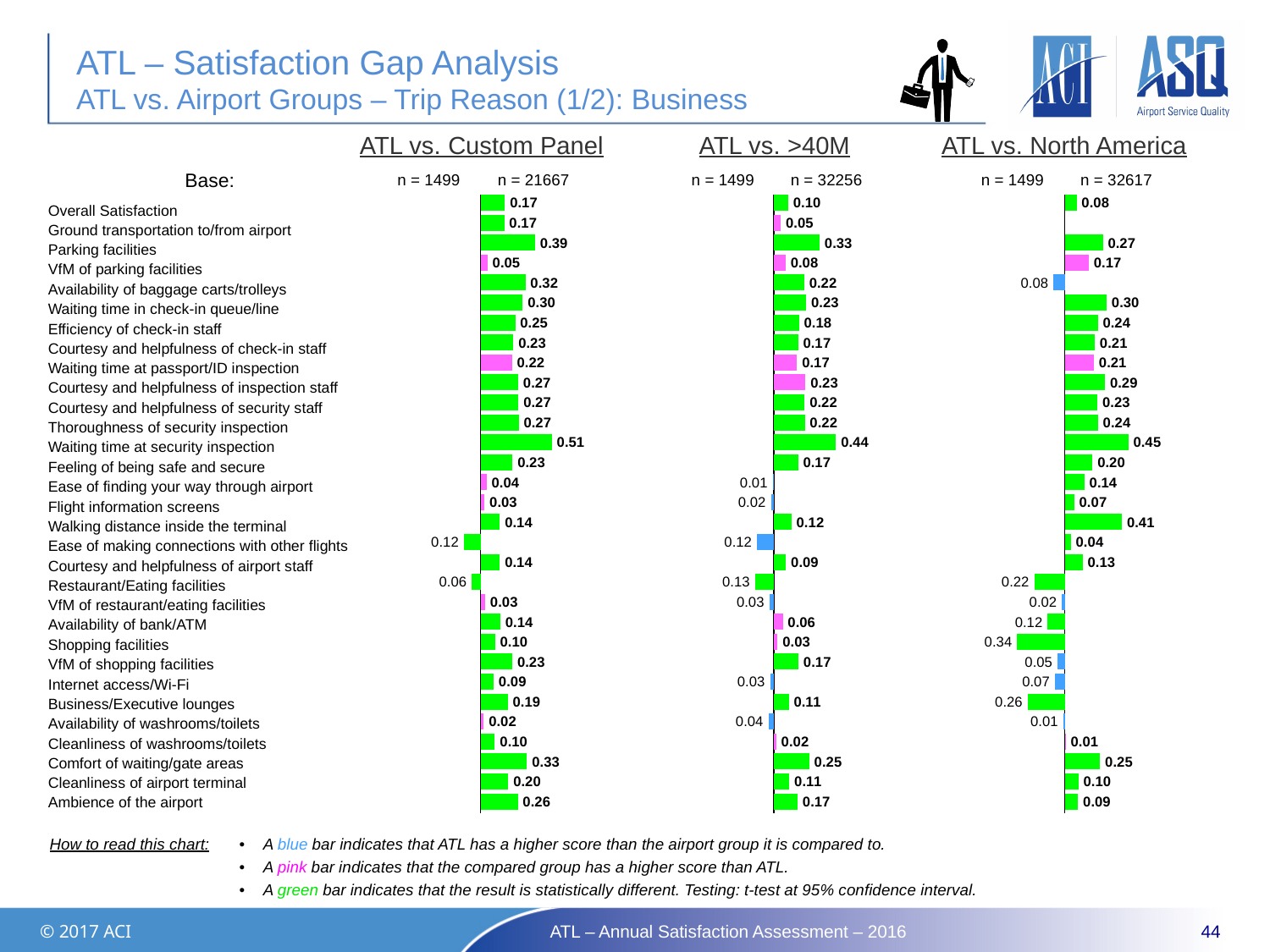
In the ATL vs. North America chart, which is larger: the value for Walking distance inside the terminal or the value for Parking facilities? Walking distance inside the terminal What kind of chart is the ATL vs. Custom Panel chart? Bar chart In the ATL vs. North America chart, what is the value for Walking distance inside the terminal? 0.41 What is the base (n) for the Custom Panel group in the ATL vs. Custom Panel chart? n = 21667 In the ATL vs. North America chart, which attribute has the highest value? Waiting time at security inspection In the ATL vs. >40M chart, which attribute has the highest value? Waiting time at security inspection In the ATL vs. >40M chart, what is the value for Ease of making connections with other flights? 0.12 How many attributes are listed in the ATL vs. Custom Panel chart? 31 In the ATL vs. Custom Panel chart, what is the difference between the values for Parking facilities and Overall Satisfaction? 0.22 In the ATL vs. Custom Panel chart, what is the value for Waiting time at security inspection? 0.51 In the ATL vs. >40M chart, what is the value for Parking facilities? 0.33 In the ATL vs. North America chart, what is the value for Shopping facilities? 0.34